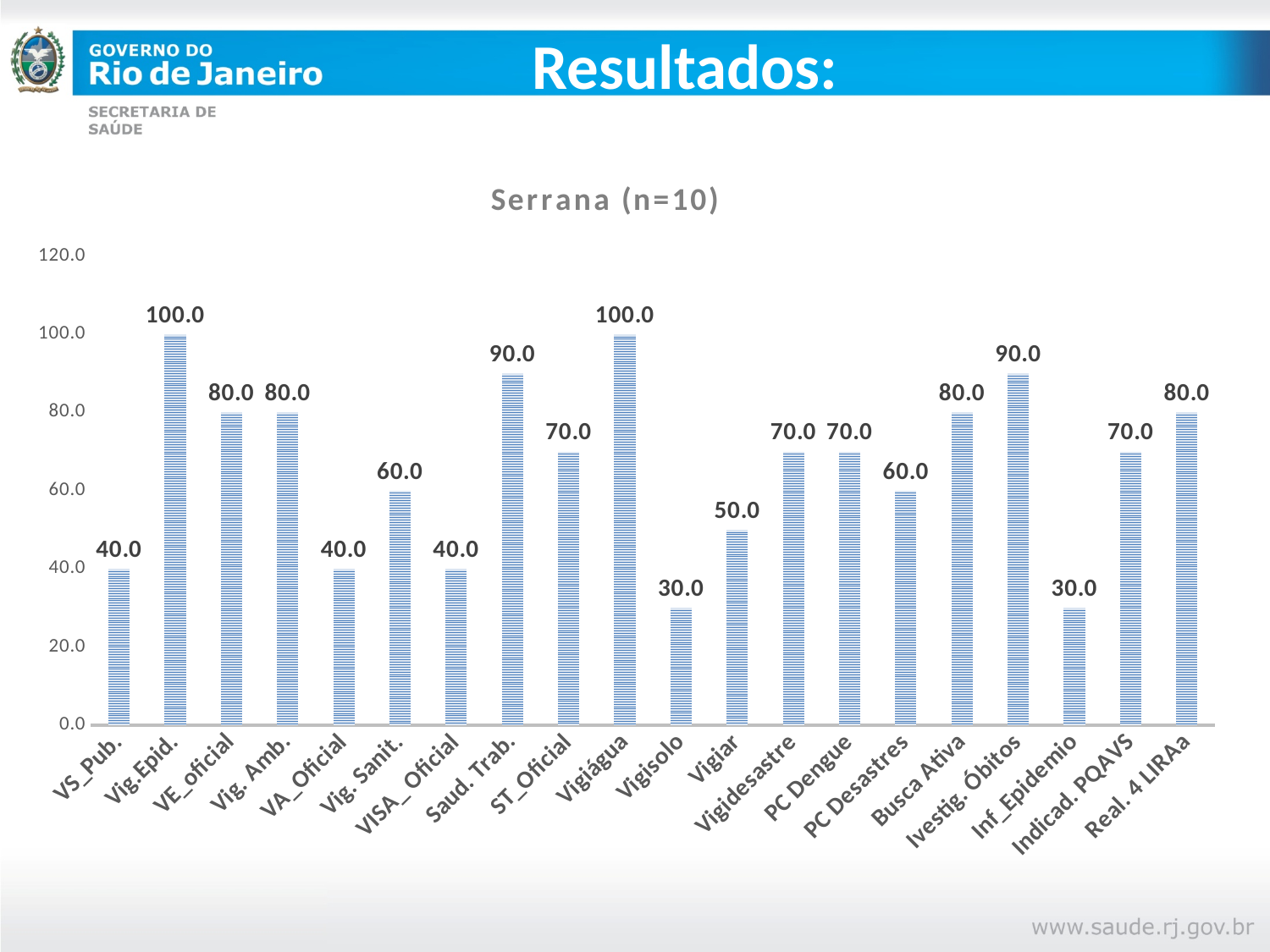
What kind of chart is shown on the slide? Bar chart What is the value for Vigisolo? 30.0 What is the value for Saud. Trab.? 90.0 What is the value for Busca Ativa? 80.0 What is the highest value shown in the chart? 100.0 How many categories are shown on the x axis? 20 What is the difference between the values for Vig.Epid. and VS_Pub.? 60.0 What is the value for Vigiar? 50.0 What is the lowest value shown in the chart? 30.0 What is the title of the chart? Serrana (n=10) Which has a larger value, Vig. Sanit. or Indicad. PQAVS? Indicad. PQAVS Is the value for Ivestig. Óbitos greater or less than 80.0? greater